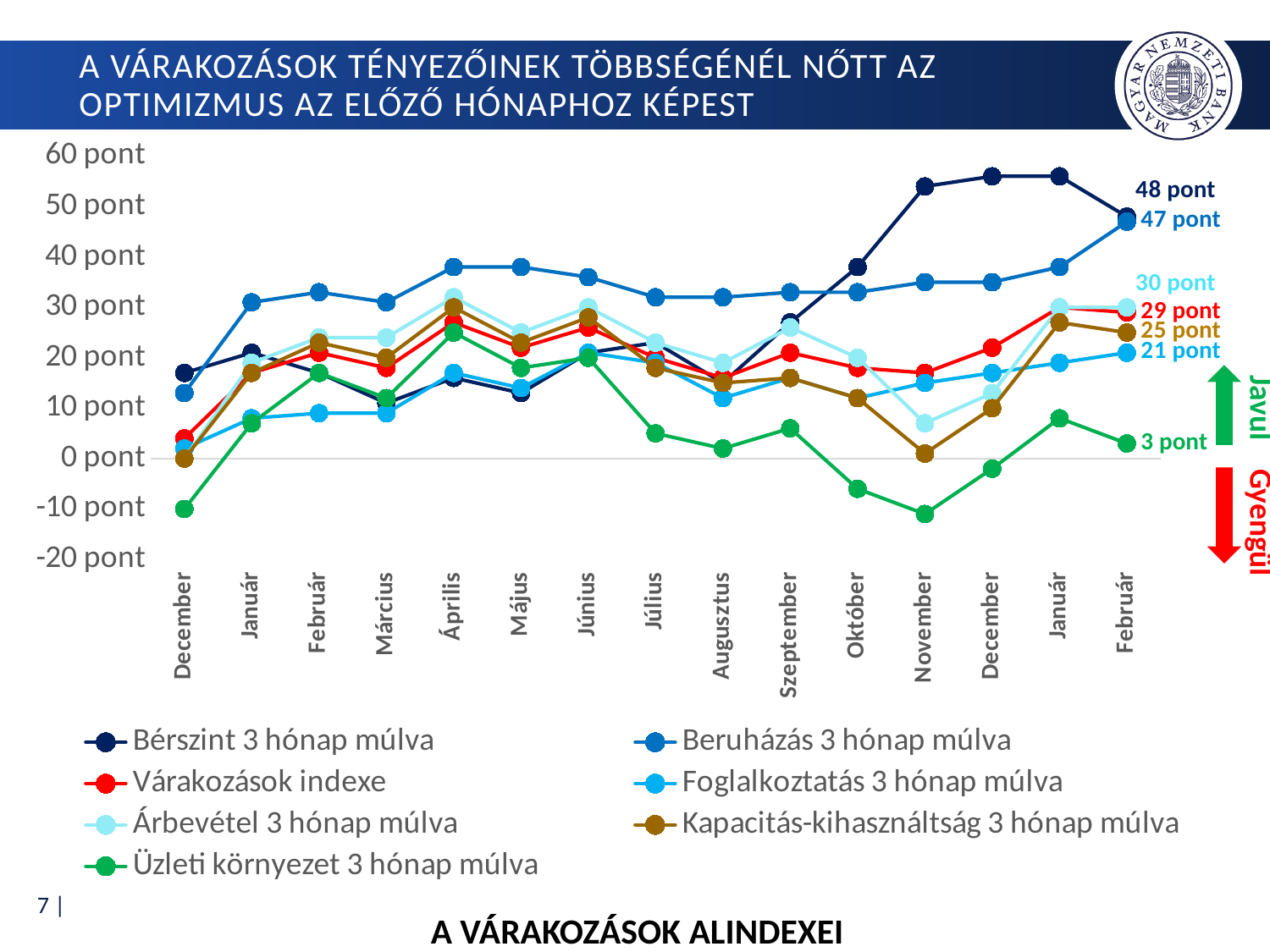
Which series has the lowest value in the final Február? Üzleti környezet 3 hónap múlva What is the title of the chart at the bottom of the slide? A VÁRAKOZÁSOK ALINDEXEI What is the value of Bérszint 3 hónap múlva in the final Február? 48 pont What is the value of Üzleti környezet 3 hónap múlva in the final Február? 3 pont What is the value of Beruházás 3 hónap múlva in the final Február? 47 pont What type of chart is shown on the slide? line chart How many series does the legend list? 7 What is the difference between Árbevétel 3 hónap múlva (30 pont) and Kapacitás-kihasználtság 3 hónap múlva (25 pont) in the final Február? 5 pont What is the value of Várakozások indexe in the final Február? 29 pont How many months are shown along the x axis? 15 Is the value of Bérszint 3 hónap múlva in December (the second December) greater or less than 50 pont? greater Is the value of Üzleti környezet 3 hónap múlva in November greater or less than 0 pont? less